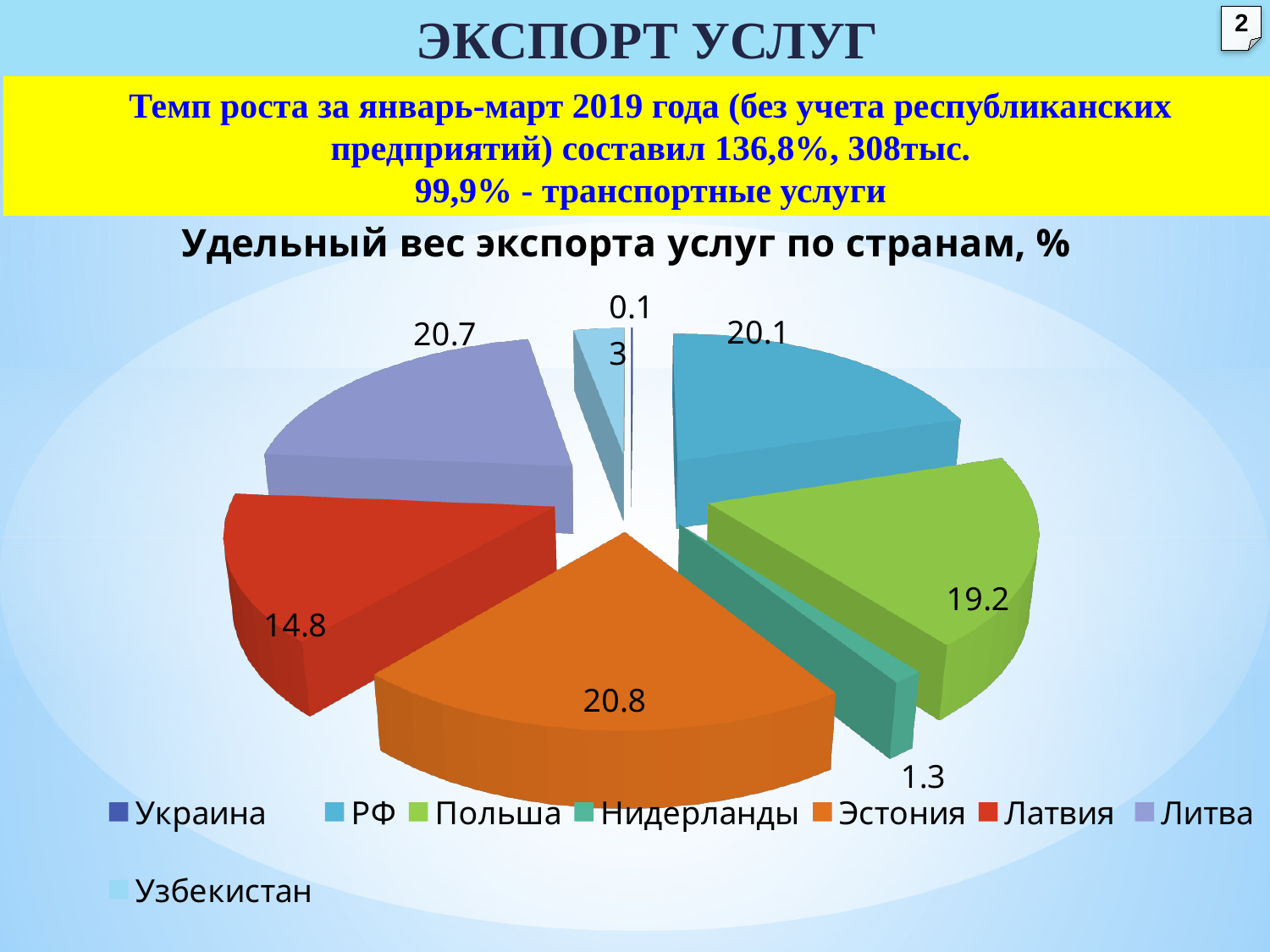
What is the value for Нидерланды in the pie chart? 1.3 What is the title of the pie chart? Удельный вес экспорта услуг по странам, % What kind of chart is shown on the slide? pie chart What is the difference between the values for Польша and Латвия? 4.4 How many countries are shown in the pie chart? 8 What is the difference between the values for РФ and Нидерланды? 18.8 What is the value for Эстония in the pie chart? 20.8 What is the value for Латвия in the pie chart? 14.8 Which country has the smallest slice in the pie chart? Украина What is the value for Узбекистан in the pie chart? 3 Which country has the largest slice in the pie chart? Эстония Which is larger, the value for Литва or the value for Латвия? Литва